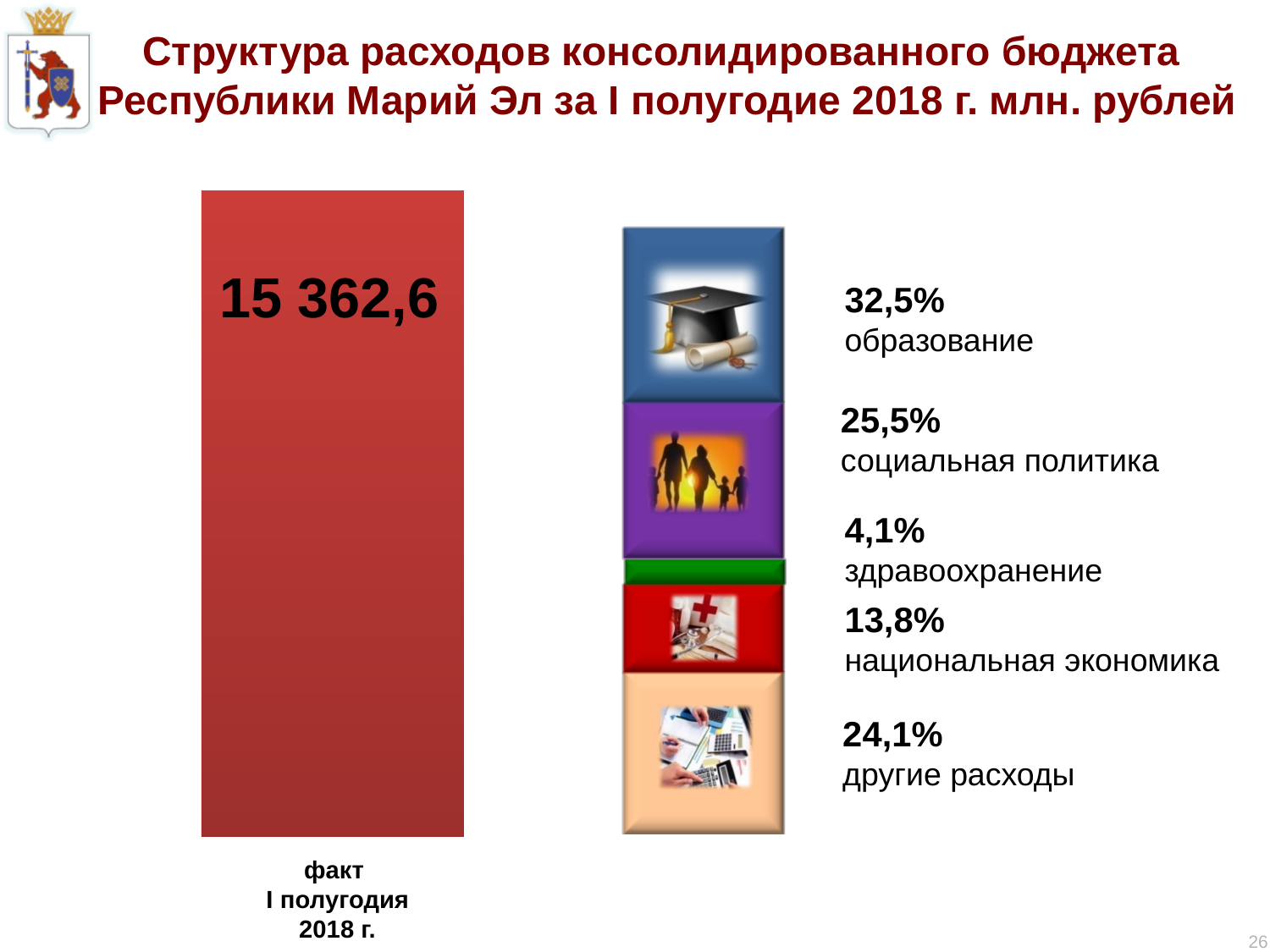
Which expenditure category has the largest share? образование What share of expenditure goes to социальная политика? 25,5% What is the difference in share between образование and здравоохранение? 28,4% What share of expenditure goes to образование? 32,5% What kind of chart is used to show the expenditure structure? bar chart What is the total expenditure value shown on the large red bar for факт I полугодия 2018 г.? 15 362,6 What share of expenditure goes to здравоохранение? 4,1% Which has a larger share, социальная политика or другие расходы? социальная политика What share of expenditure goes to национальная экономика? 13,8% What share of expenditure goes to другие расходы? 24,1% Which expenditure category has the smallest share? здравоохранение How many expenditure categories are shown in the stacked bar? 5